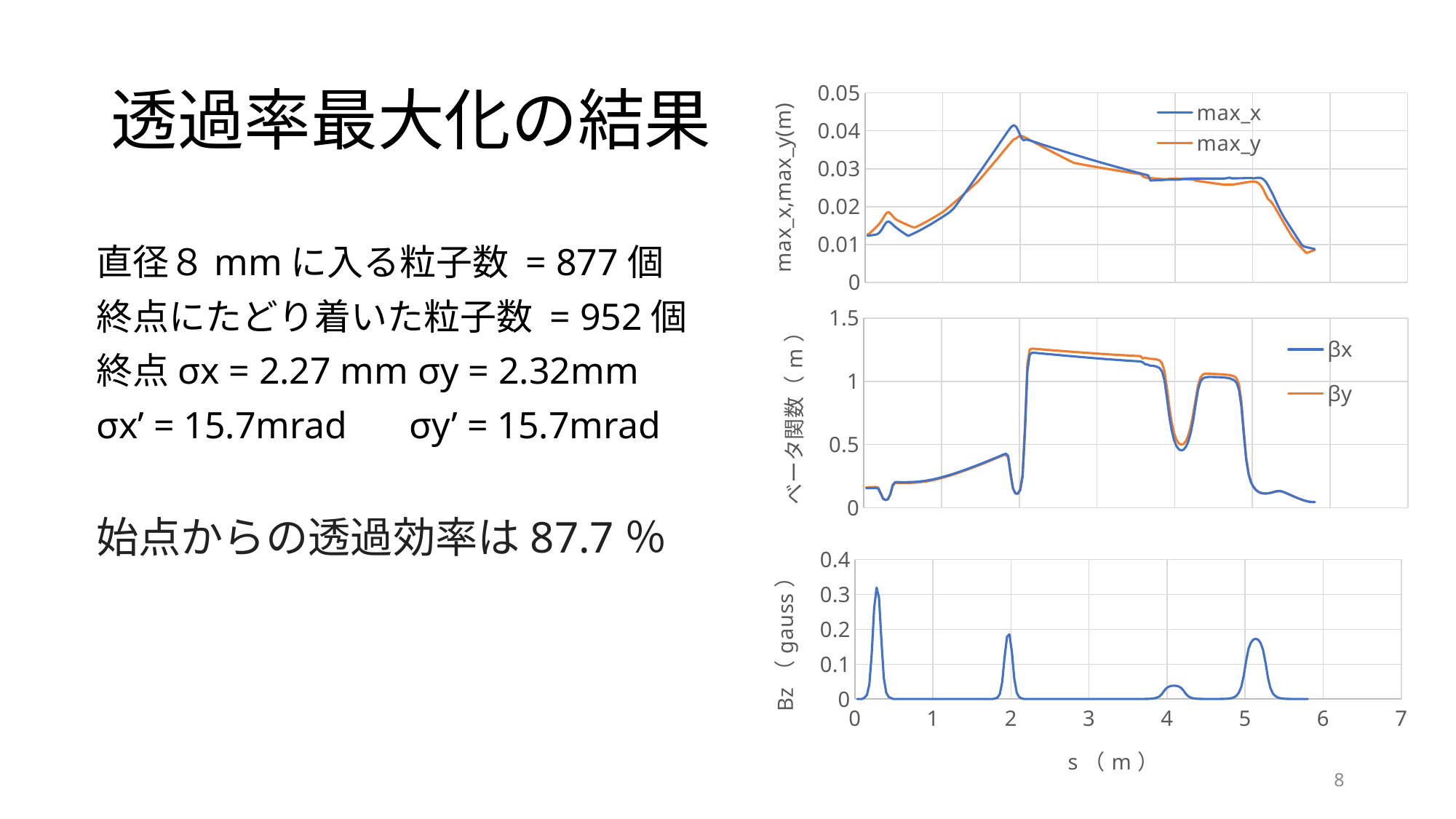
In the top chart, is the value of max_x at s = 4 greater or less than 0.03? less How many charts are shown on the right side of the slide? 3 In the middle chart (ベータ関数), is the value of βx at s = 3 greater or less than 1? greater In the top chart, does max_x rise or fall along the x axis from s = 2 to s = 6? fall In the bottom chart (Bz), how many peaks does the curve show? 4 In the middle chart (ベータ関数), is the value of βy at s = 1 greater or less than 0.5? less In the middle chart (ベータ関数), what are the two legend entries? βx, βy What kind of chart is the top chart on the slide (max_x, max_y)? line chart What is the x-axis label shared by the three charts? s（m） How many series does the legend of the top chart (max_x, max_y) list? 2 In the bottom chart (Bz), which peak is higher: the one near s = 0.3 or the one near s = 5? the one near s = 0.3